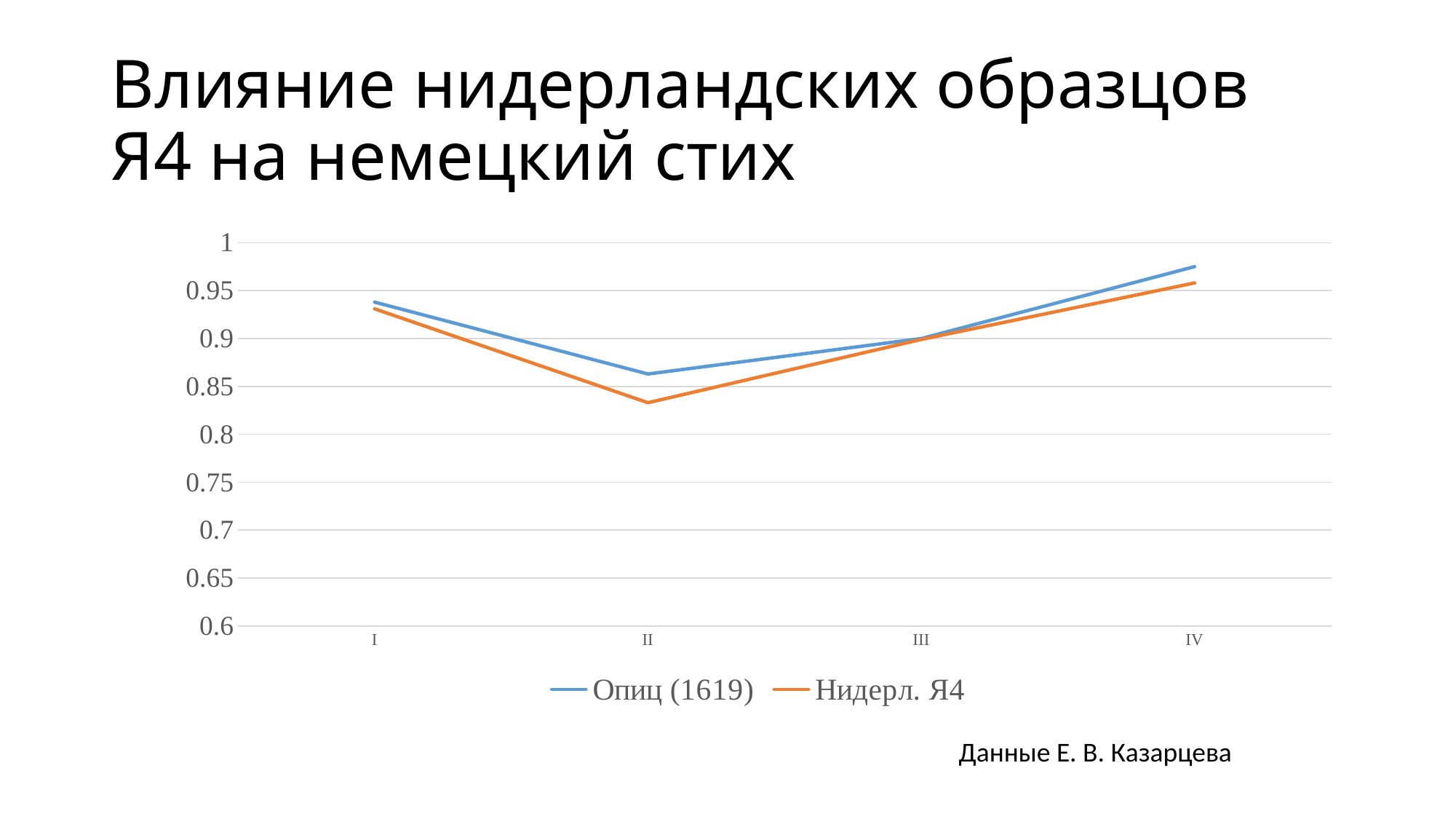
At which category does the Нидерл. Я4 series reach its lowest value? II At which category does the Опиц (1619) series reach its lowest value? II At which category does the Опиц (1619) series reach its highest value? IV Do the values of both series rise or fall from category II to category IV? rise Is the value of Опиц (1619) at category IV greater or less than 0.95? greater At category II, which series has the higher value, Опиц (1619) or Нидерл. Я4? Опиц (1619) Is the value of Опиц (1619) at category II greater or less than 0.9? less At which category does the Нидерл. Я4 series reach its highest value? IV Is the value of Нидерл. Я4 at category II greater or less than 0.85? less What kind of chart is shown on the slide? line chart How many categories are shown on the x axis? 4 How many series does the legend list? 2